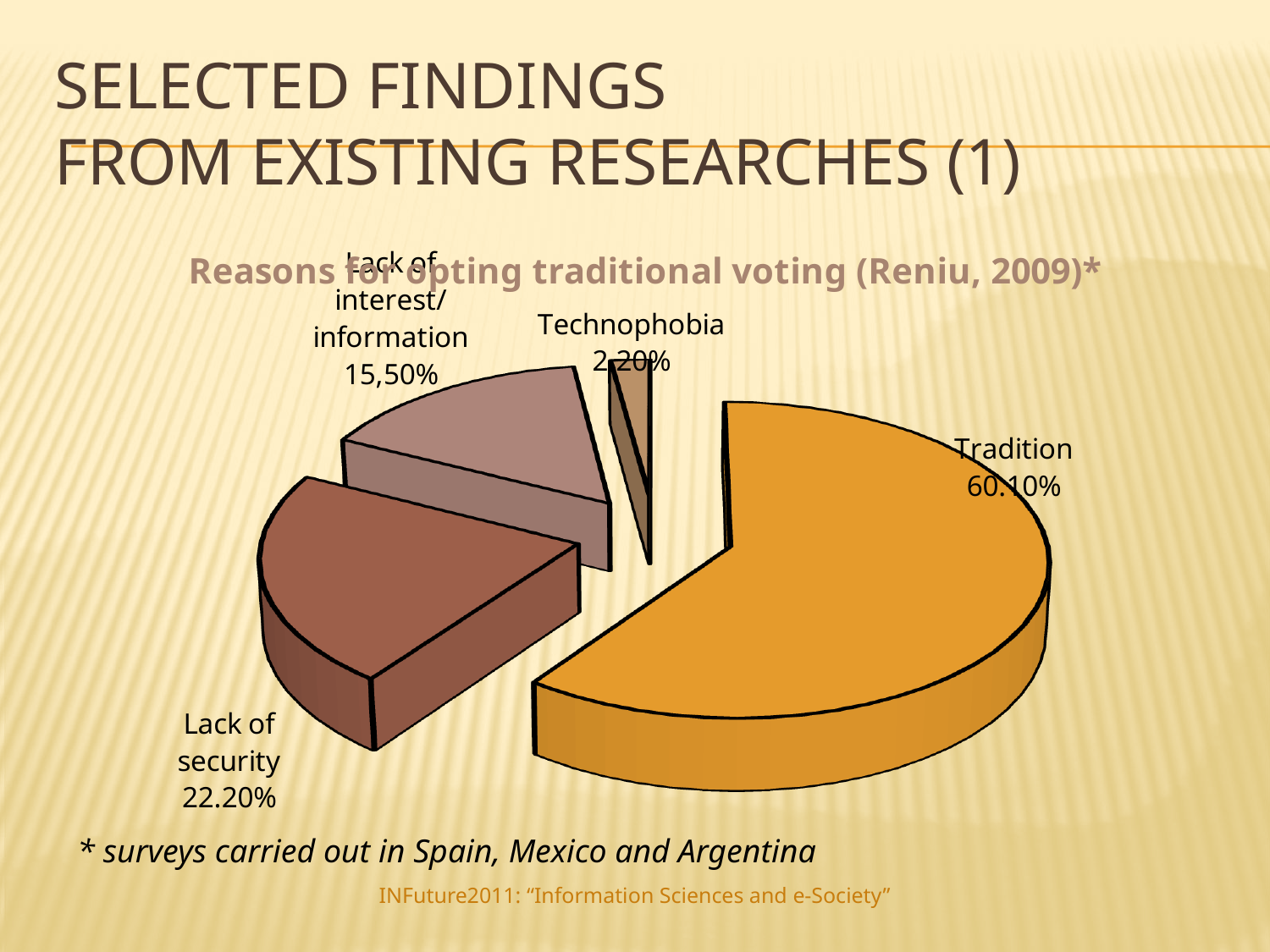
Which reason has the smallest slice of the pie? Technophobia Which reason has the largest slice of the pie? Tradition What is the value shown for Technophobia? 2.20% What kind of chart is shown on the slide? Pie chart How many slices does the pie chart have? 4 What is the title of the chart? Reasons for opting traditional voting (Reniu, 2009)* What is the difference between the Tradition and Lack of security values? 37.90% According to the footnote, in which countries were the surveys carried out? Spain, Mexico and Argentina What is the value shown for Lack of security? 22.20% What is the value shown for Lack of interest/information? 15,50% Which is larger, Lack of security or Lack of interest/information? Lack of security What share of the pie is labelled Tradition? 60.10%